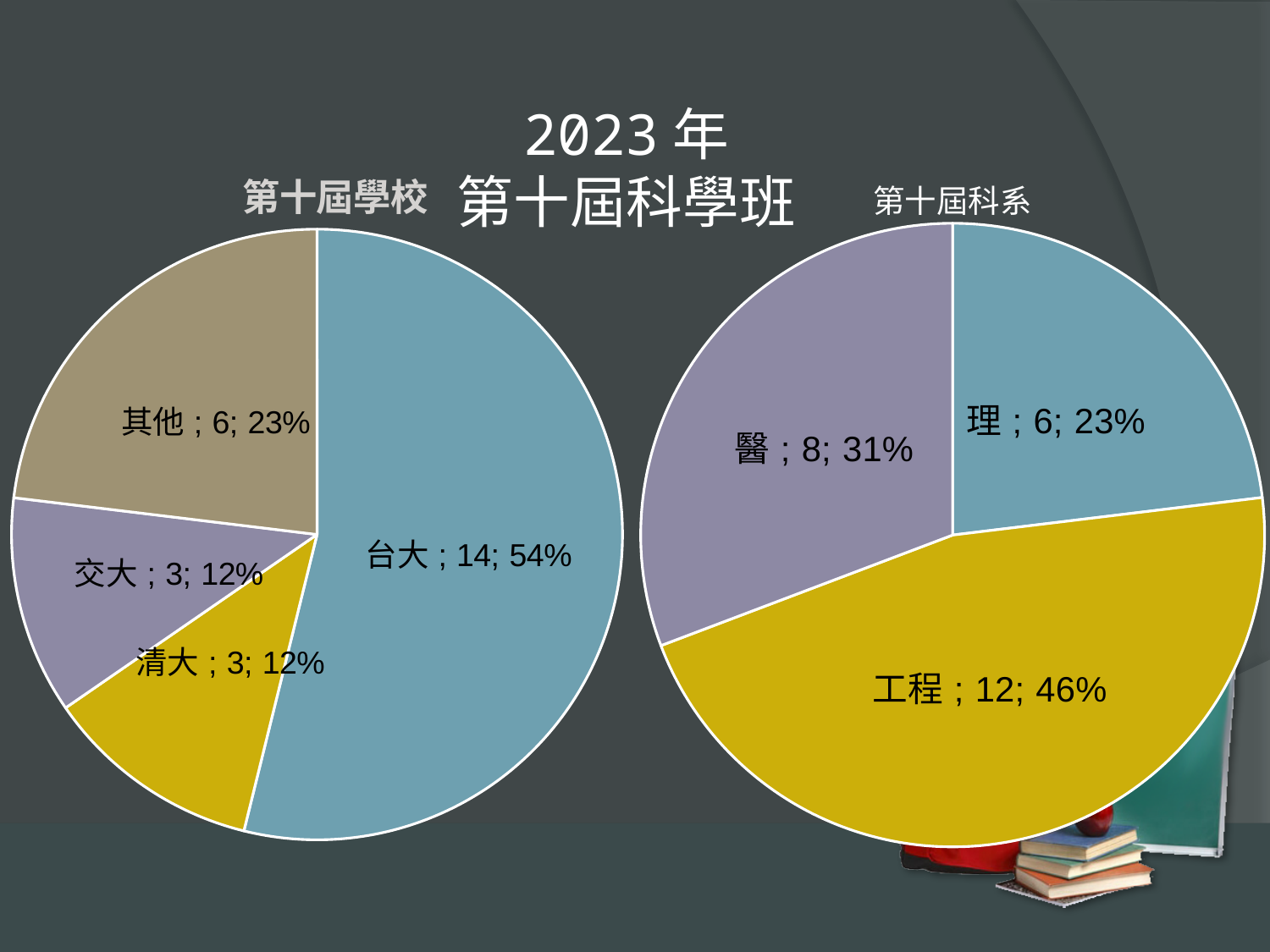
In the 第十屆學校 pie chart, how many students went to 台大? 14 In the 第十屆科系 pie chart, how many slices are there? 3 In the 第十屆科系 pie chart, which is larger, 醫 or 理? 醫 In the 第十屆學校 pie chart, how many slices are there? 4 In the 第十屆學校 pie chart, which category has the largest slice? 台大 In the 第十屆科系 pie chart, what share of the pie does 醫 represent? 31% In the 第十屆科系 pie chart, which category has the smallest slice? 理 In the 第十屆科系 pie chart, how many students are in 工程? 12 What type of chart is used for 第十屆學校? Pie chart In the 第十屆學校 pie chart, what is the difference between the 台大 count and the 其他 count? 8 In the 第十屆學校 pie chart, what share of the pie does 其他 represent? 23% What is the main title shown above the two charts? 2023 年 第十屆科學班